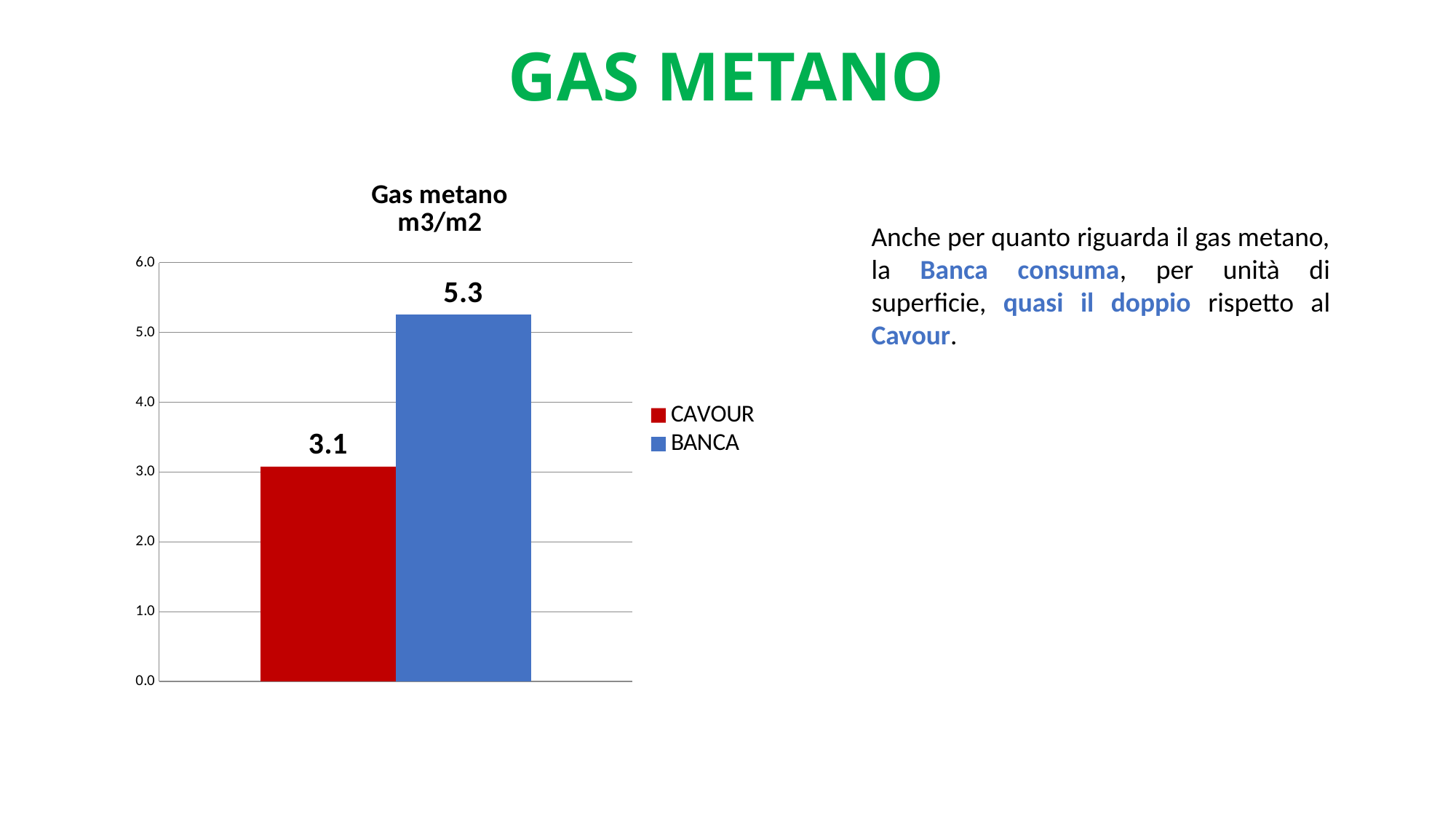
What is the value for BANCA in the Gas metano m3/m2 chart? 5.3 What is the value for CAVOUR in the Gas metano m3/m2 chart? 3.1 Which series has the lowest value in the chart? CAVOUR How many series does the legend list? 2 What kind of chart is shown on the slide? bar chart What is the difference between the BANCA and CAVOUR values? 2.2 Which series has the highest value in the chart? BANCA Is the value for CAVOUR greater or less than 4.0? less Is the value for BANCA greater or less than 5.0? greater Which is larger, the value for CAVOUR or the value for BANCA? BANCA How many bars are plotted in the chart? 2 What colour is the BANCA bar in the chart? blue